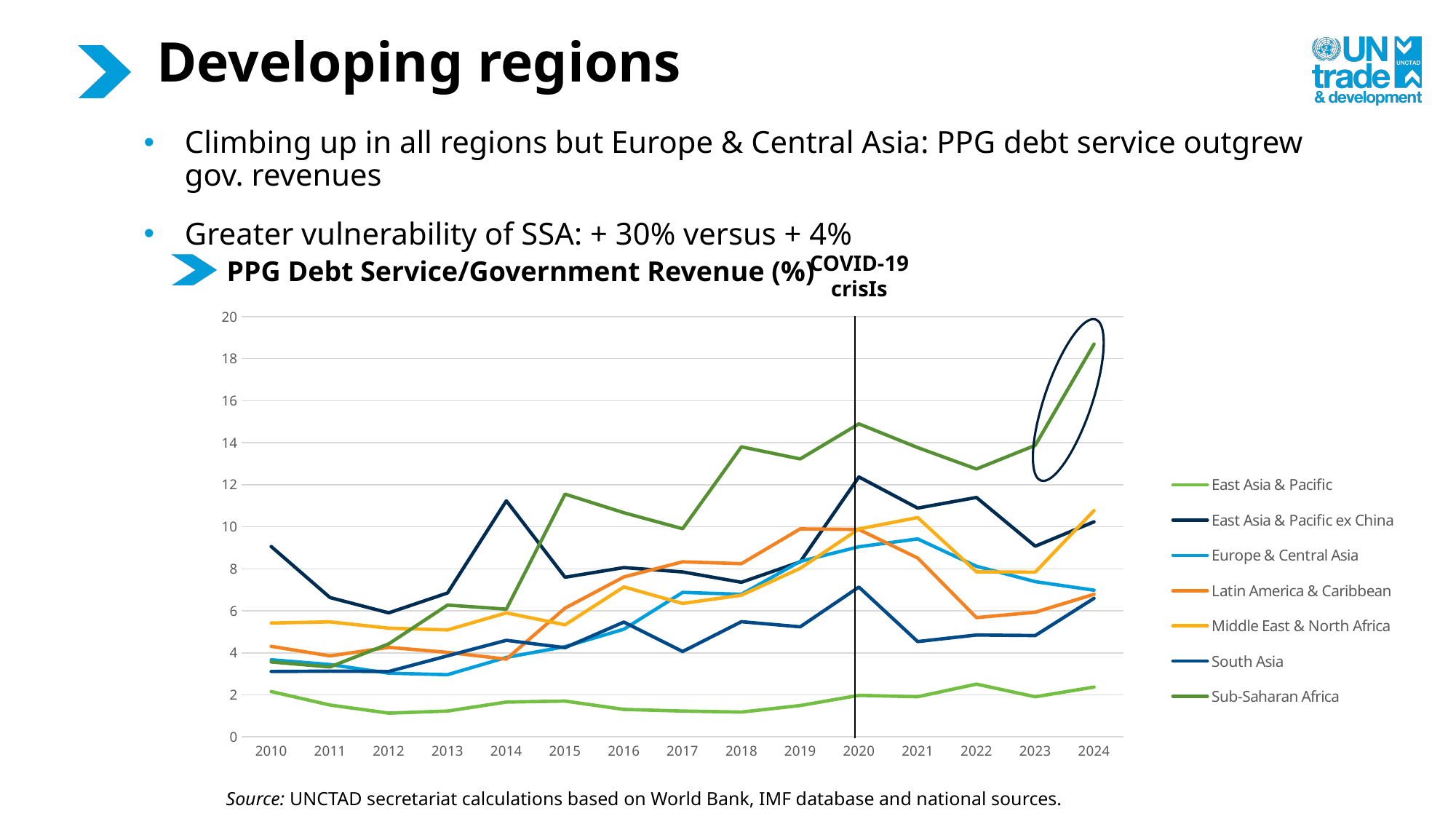
How many series does the legend of the chart list? 7 Which region has the lowest value in 2024? East Asia & Pacific Which region has the highest value in 2014? East Asia & Pacific ex China How many years are shown along the x axis of the chart? 15 Is the value for Europe & Central Asia in 2021 greater or less than 8? greater Is the value for Sub-Saharan Africa in 2024 greater or less than 16? greater Which region has the highest value in 2024? Sub-Saharan Africa What kind of chart is shown on the slide? line chart What is the title of the chart? PPG Debt Service/Government Revenue (%) Is the value for East Asia & Pacific in 2010 greater or less than 4? less Does the value for Sub-Saharan Africa rise or fall from 2022 to 2024? rise In 2024, which is larger: the value for Sub-Saharan Africa or the value for Europe & Central Asia? Sub-Saharan Africa